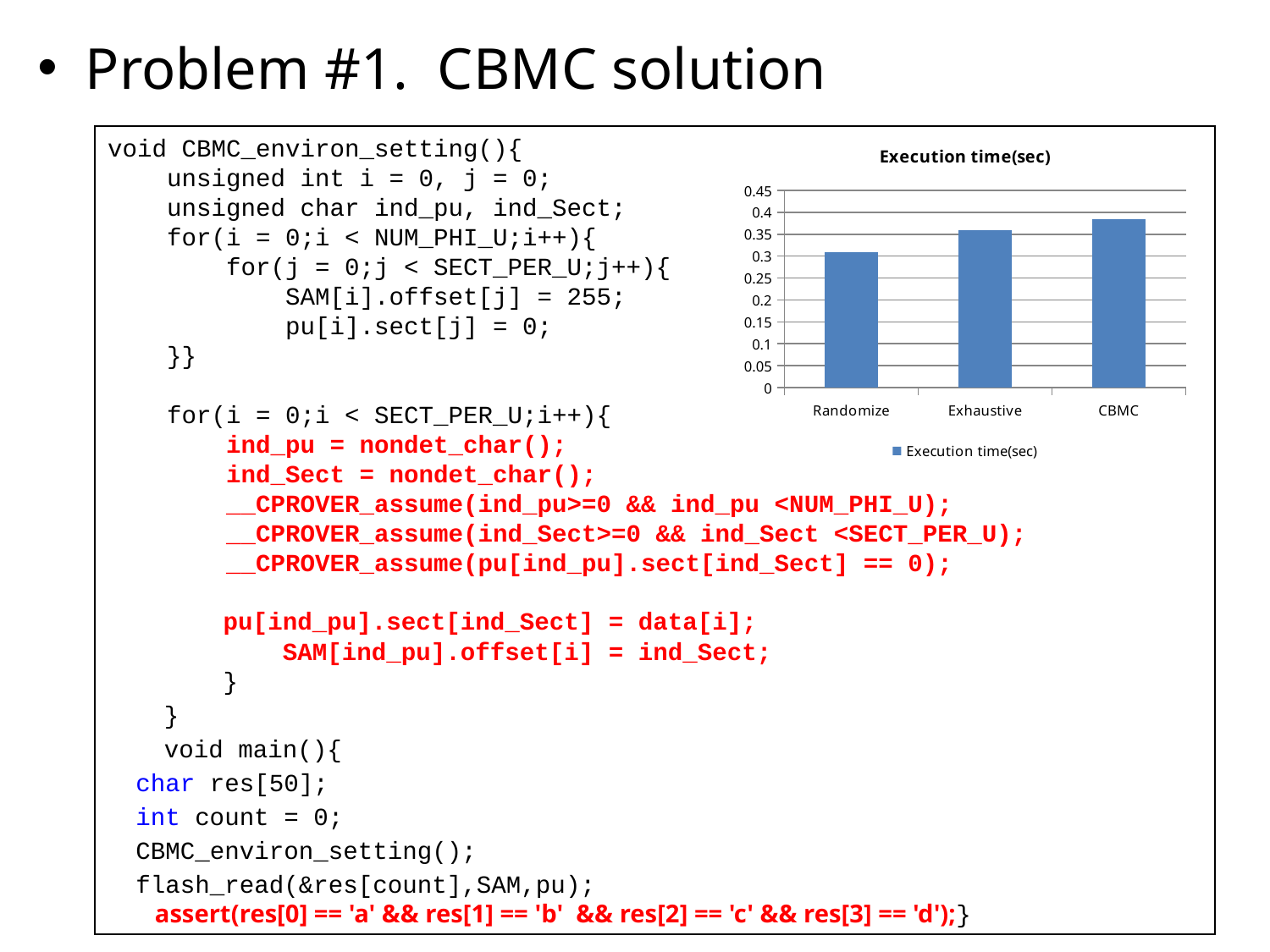
Is the value for Exhaustive greater or less than 0.4? less Do the execution times rise or fall from Randomize to CBMC along the x axis? rise What is the title of the chart? Execution time(sec) Which has a larger execution time, Randomize or Exhaustive? Exhaustive How many series does the chart's legend list? 1 Which has a larger execution time, Randomize or CBMC? CBMC How many categories are plotted in the chart? 3 Is the value for CBMC greater or less than 0.35? greater Which category has the lowest execution time? Randomize Which category has the highest execution time? CBMC What kind of chart is shown on the slide? bar chart Is the value for Randomize greater or less than 0.35? less